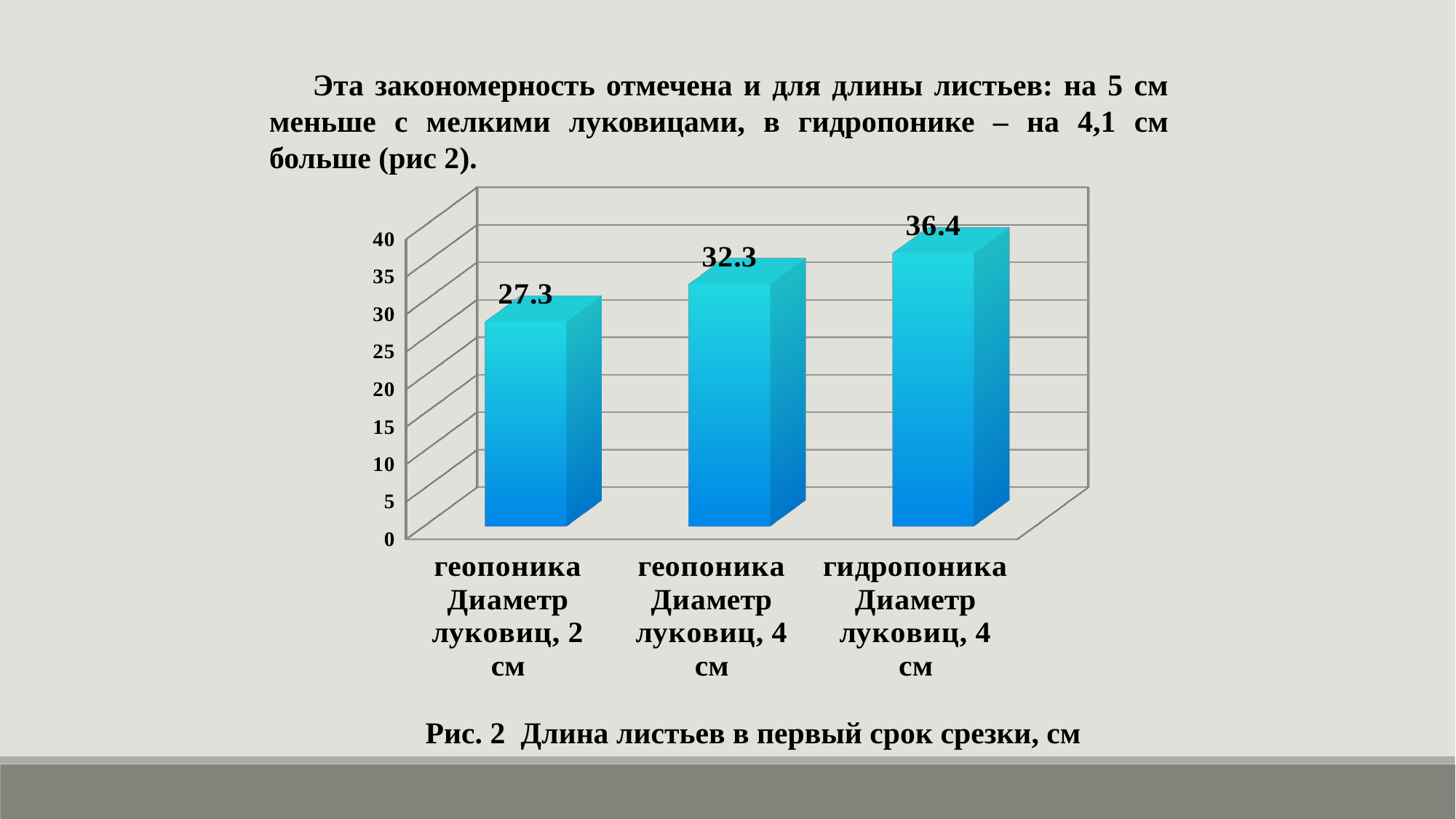
Which category has the lowest value? геопоника Диаметр луковиц, 2 см Which category has the highest value? гидропоника Диаметр луковиц, 4 см What kind of chart is shown on the slide? bar chart Which is larger: the value for 'геопоника Диаметр луковиц, 2 см' or 'геопоника Диаметр луковиц, 4 см'? геопоника Диаметр луковиц, 4 см What is the value for 'геопоника Диаметр луковиц, 2 см'? 27.3 Do the values rise or fall from left to right across the categories? rise What is the difference between the values for 'геопоника Диаметр луковиц, 4 см' and 'геопоника Диаметр луковиц, 2 см'? 5 What is the value for 'геопоника Диаметр луковиц, 4 см'? 32.3 What is the value for 'гидропоника Диаметр луковиц, 4 см'? 36.4 How many categories are shown in the chart? 3 What is the difference between the values for 'гидропоника Диаметр луковиц, 4 см' and 'геопоника Диаметр луковиц, 4 см'? 4.1 Is the value for 'гидропоника Диаметр луковиц, 4 см' greater or less than 35? greater